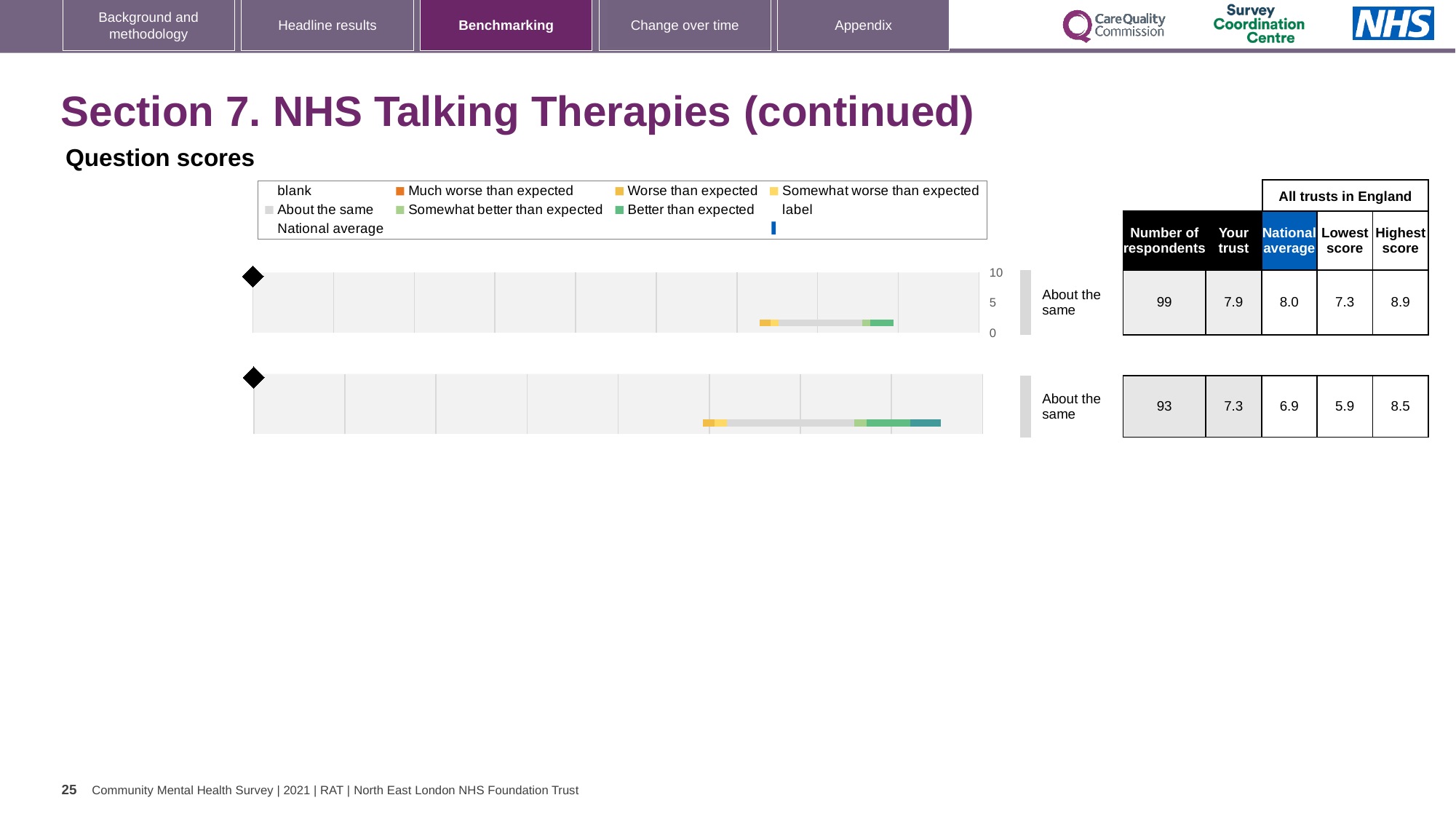
For the bottom chart, what is the lowest score among all trusts in England? 5.9 What kind of chart is used on this slide to show the question scores? bar chart For the top chart, what is the 'Your trust' score? 7.9 For the bottom chart, what is the highest score among all trusts in England? 8.5 For the bottom chart, which is larger: the 'Your trust' score or the national average? Your trust How many question score charts (rows) are shown on the slide? 2 For the top chart, which is larger: the 'Your trust' score or the national average? National average What benchmark category label is shown next to the bottom chart? About the same For the bottom chart, what is the difference between the 'Your trust' score and the national average? 0.4 For the top chart, what is the national average score? 8.0 For the top chart, what is the difference between the highest score and the lowest score? 1.6 For the top chart, what is the number of respondents shown in the table? 99